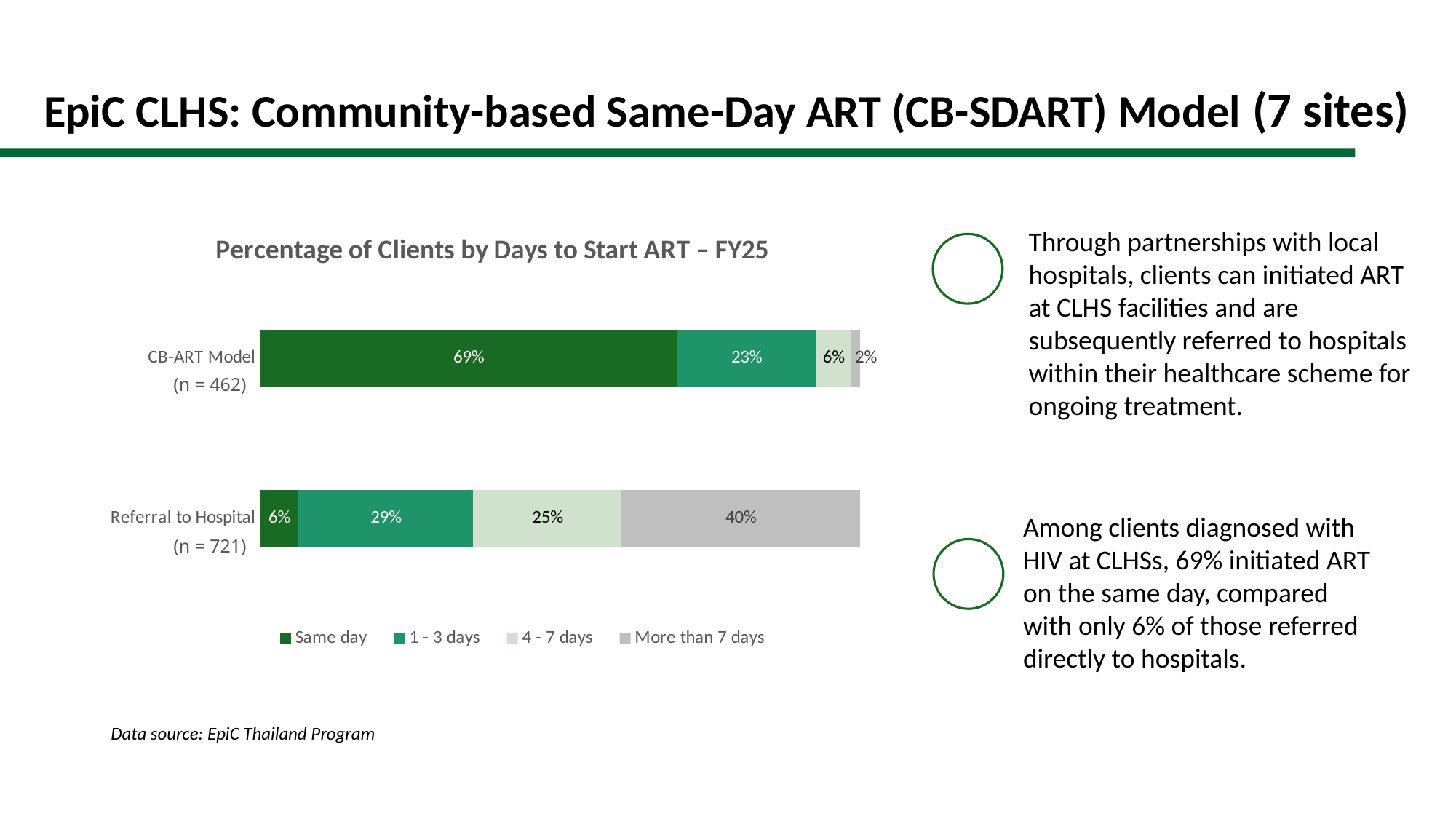
How many categories (bars) are shown in the chart? 2 What percentage of Referral to Hospital clients started ART more than 7 days after diagnosis? 40% Which segment is the smallest in the CB-ART Model bar? More than 7 days Which category has the higher Same day percentage, CB-ART Model or Referral to Hospital? CB-ART Model What percentage of CB-ART Model clients started ART on the same day? 69% What is the value for 4 - 7 days in the CB-ART Model bar? 6% What kind of chart is shown on the slide? Stacked bar chart How many series does the legend list? 4 What is the value for 1 - 3 days in the Referral to Hospital bar? 29% What is the difference between the Same day percentage for CB-ART Model and for Referral to Hospital? 63% What is the title of the chart? Percentage of Clients by Days to Start ART – FY25 Which segment is the largest in the Referral to Hospital bar? More than 7 days